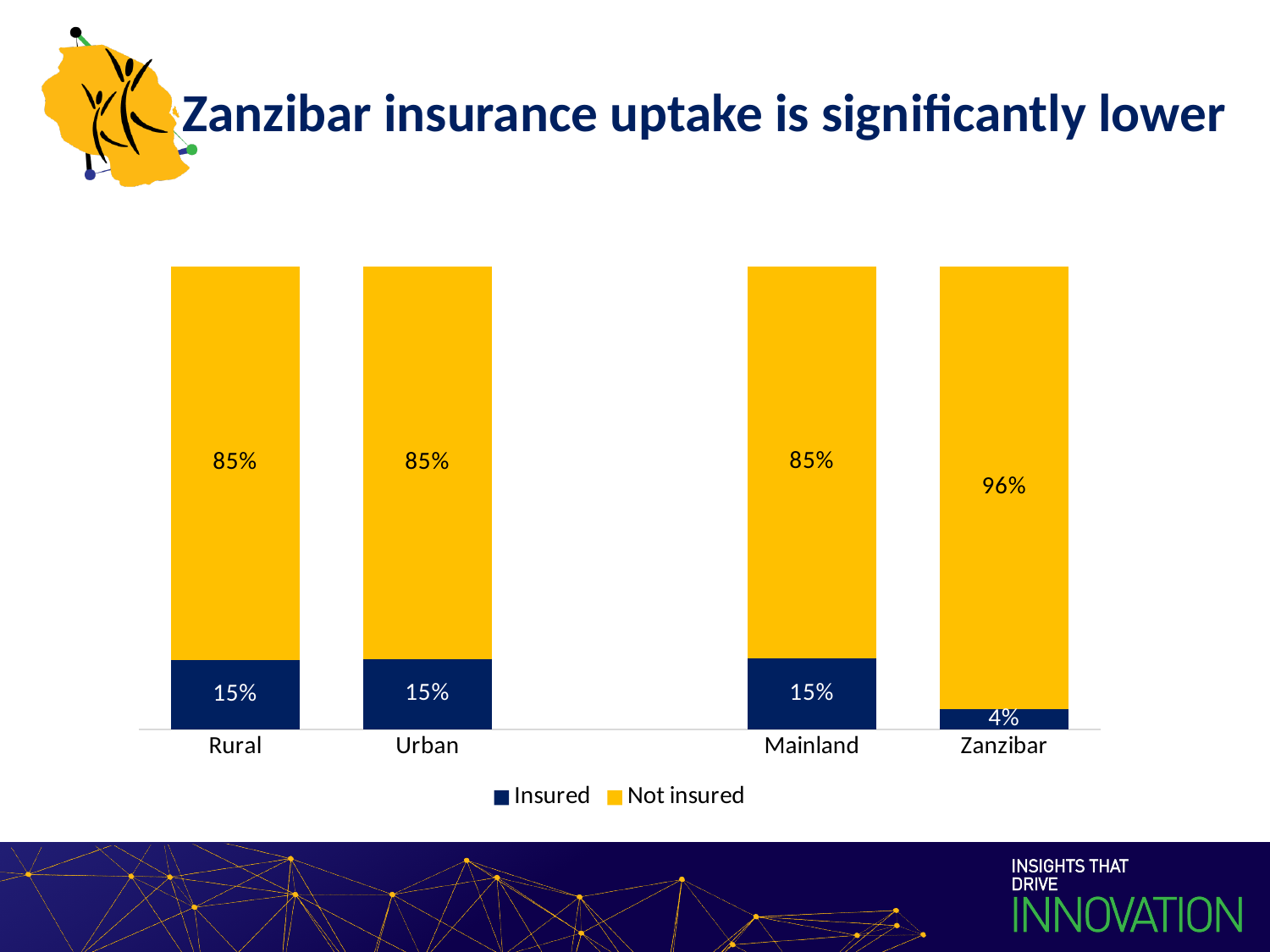
What kind of chart is shown on the slide? Stacked bar chart Which is larger, the Not insured value for Urban or for Zanzibar? Zanzibar What is the Not insured value for Mainland? 85% What is the Insured value for Rural? 15% What is the difference between the Insured values for Mainland and Zanzibar? 11% Which category has the highest Not insured value? Zanzibar What is the Not insured value for Zanzibar? 96% How many categories are shown on the x axis? 4 Which category has the lowest Insured value? Zanzibar How many series does the legend list? 2 What is the total of the stacked bar for Zanzibar? 100% What is the Insured value for Zanzibar? 4%